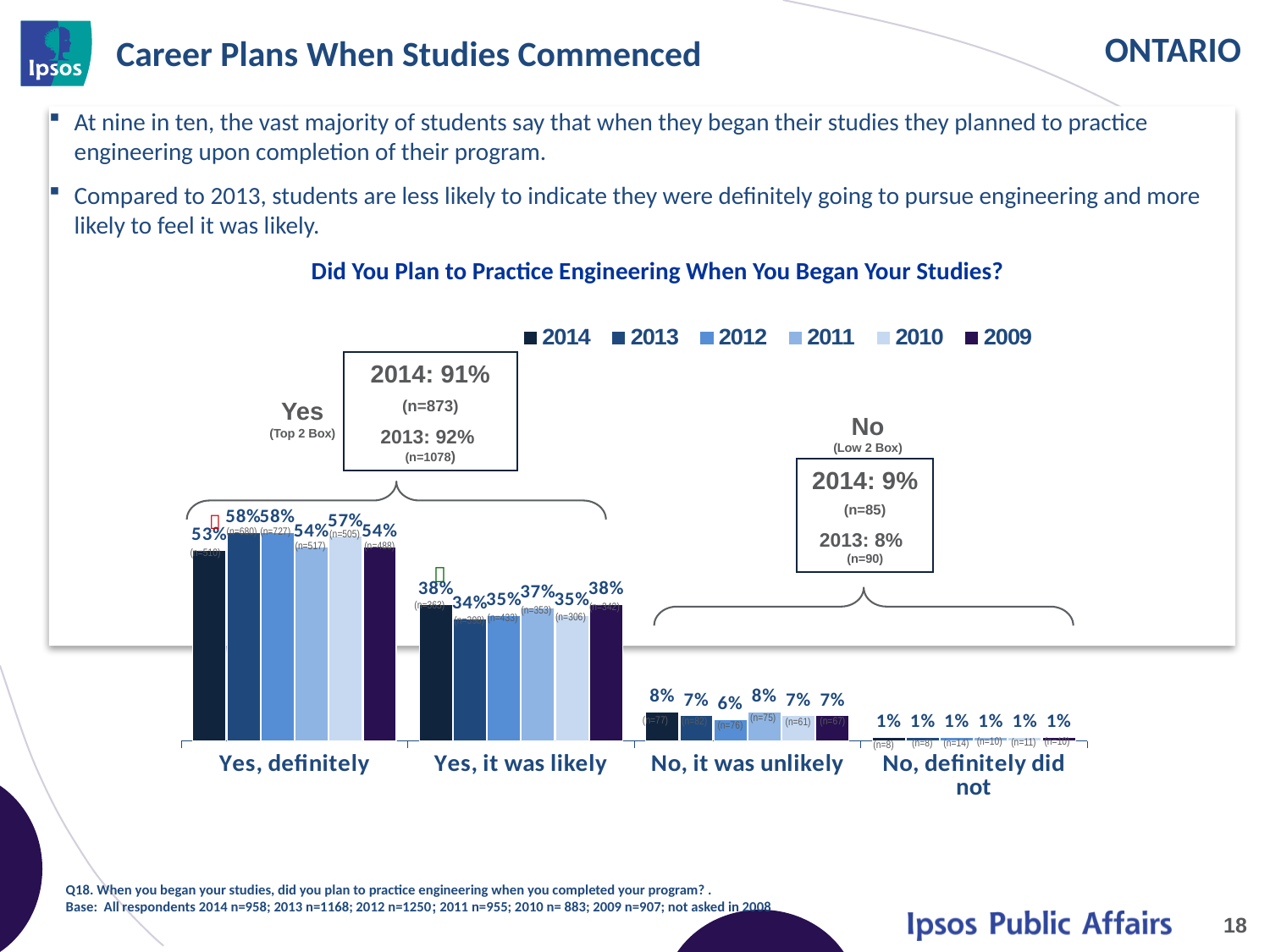
What is the 2013 value for "Yes, it was likely"? 34% What is the 2009 value for "No, definitely did not"? 1% How many series does the legend list? 6 Which year has the highest value for "Yes, it was likely"? 2014 and 2009 (38%) Which year has the lowest value for "Yes, definitely"? 2014 What is the difference between the 2013 and 2014 values for "Yes, definitely"? 5% How many response categories are shown on the x axis? 4 What is the 2014 Top 2 Box (Yes) percentage shown in the callout? 91% What kind of chart is shown on the slide? bar chart What is the 2012 value for "No, it was unlikely"? 6% What is the 2014 value for "Yes, definitely"? 53% Which is larger for 2011: "Yes, definitely" or "Yes, it was likely"? Yes, definitely